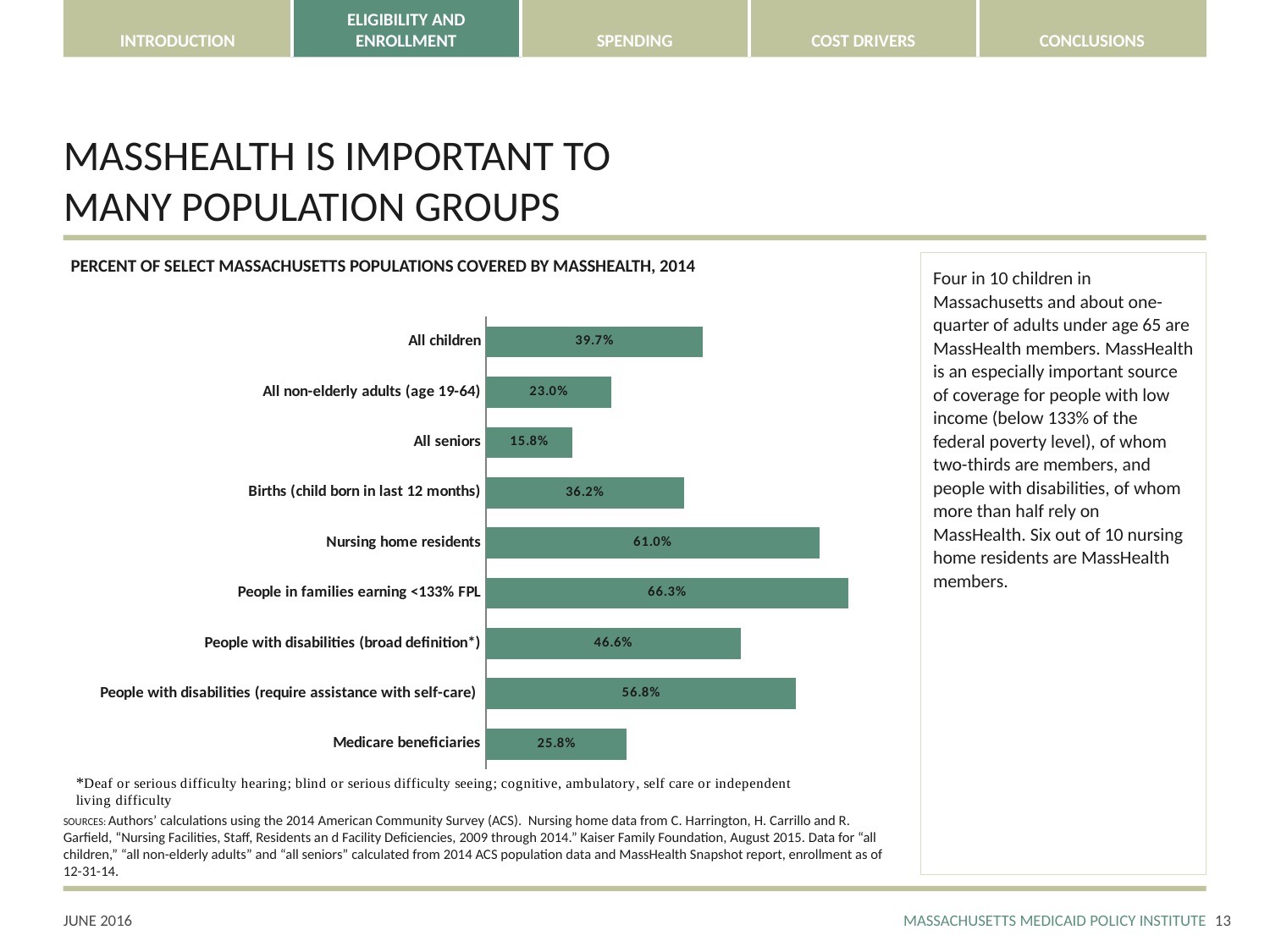
Which population group has the highest percent covered by MassHealth? People in families earning <133% FPL How many population groups are shown in the chart? 9 Which is larger: the value for people with disabilities (broad definition*) or the value for people with disabilities (require assistance with self-care)? People with disabilities (require assistance with self-care) What percent of Medicare beneficiaries are covered by MassHealth? 25.8% What is the difference between the value for nursing home residents and the value for births (child born in last 12 months)? 24.8% What is the title of the chart? Percent of select Massachusetts populations covered by MassHealth, 2014 Which population group has the lowest percent covered by MassHealth? All seniors What percent of all children are covered by MassHealth? 39.7% What is the difference between the value for all children and the value for all seniors? 23.9% What kind of chart is shown on the slide? Bar chart What is the value for all non-elderly adults (age 19-64)? 23.0% What is the value for nursing home residents? 61.0%